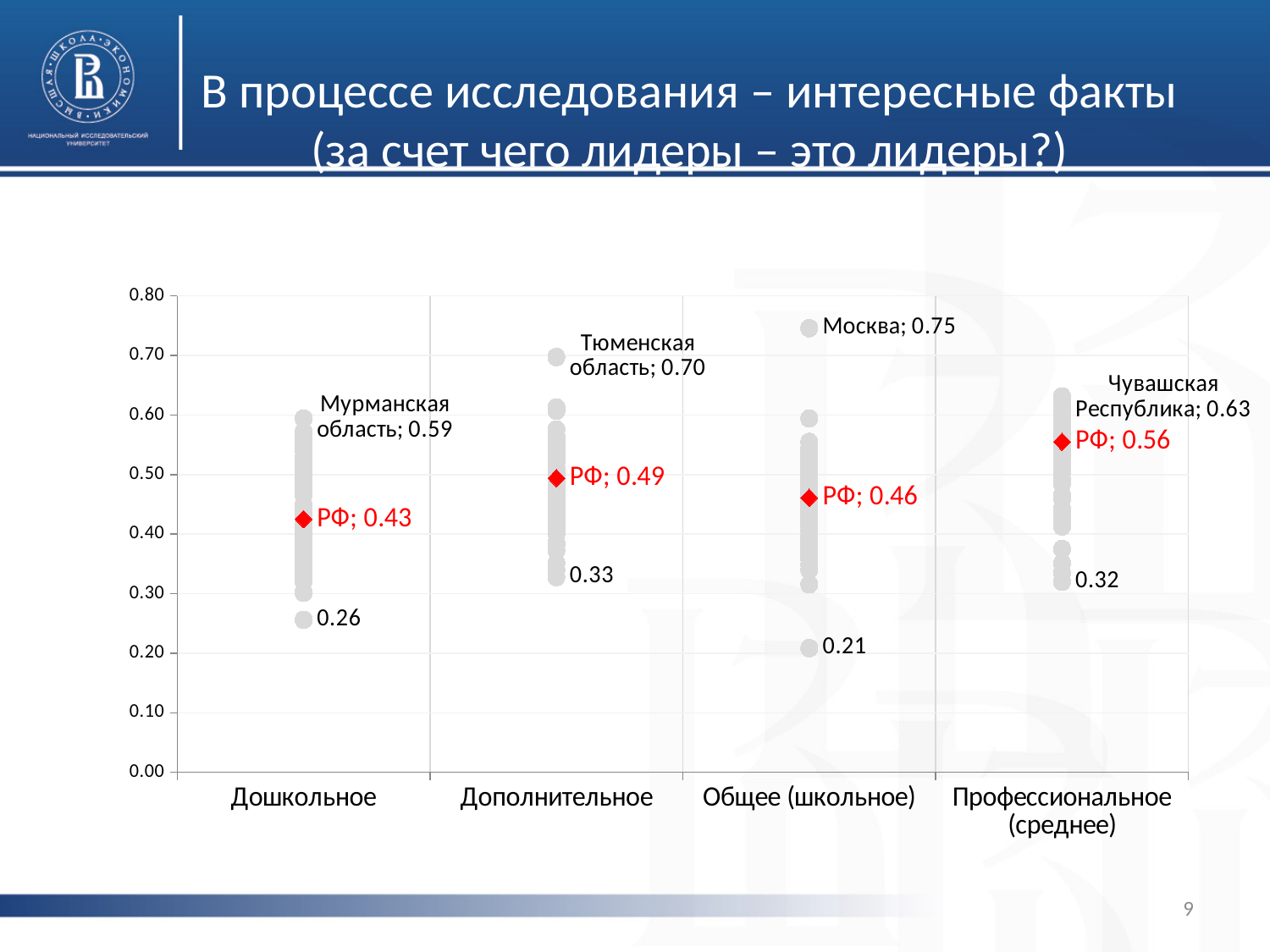
What is the value labelled for Тюменская область in the Дополнительное category? 0.70 What is the difference between the РФ values for Профессиональное (среднее) and Дошкольное? 0.13 What is the difference between the highest and lowest labelled values in the Дошкольное category (Мурманская область and the minimum)? 0.33 What is the РФ value for the Дошкольное category? 0.43 Is the value for Чувашская Республика greater or less than 0.60? greater What is the РФ value for the Профессиональное (среднее) category? 0.56 Which is larger: the РФ value for Дополнительное or for Общее (школьное)? Дополнительное Which category has the highest РФ value? Профессиональное (среднее) Which category has the lowest РФ value? Дошкольное What is the lowest labelled value in the Общее (школьное) category? 0.21 What is the value labelled for Москва in the Общее (школьное) category? 0.75 How many categories are shown on the x axis? 4